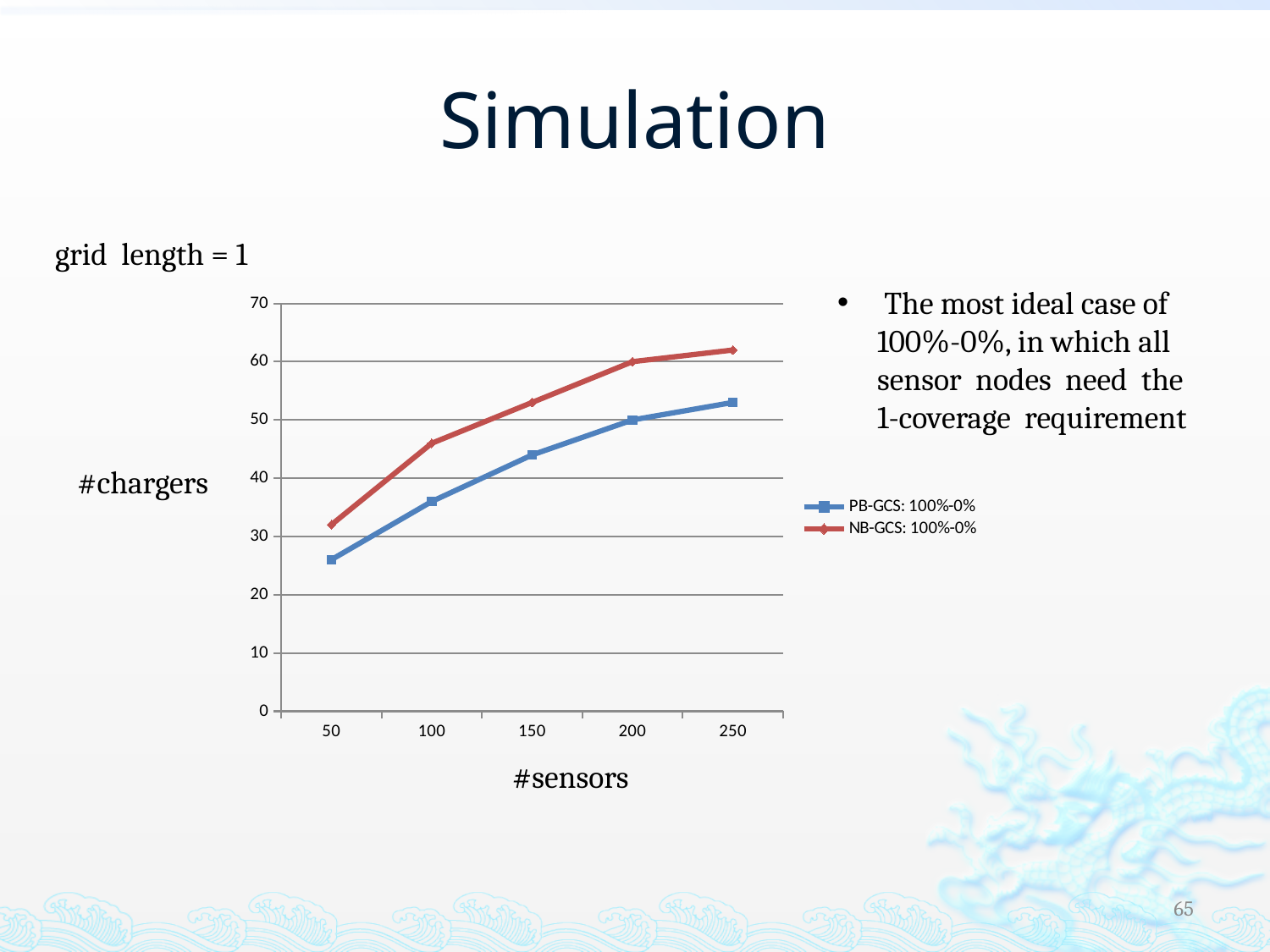
Is the value for PB-GCS: 100%-0% at 100 sensors greater or less than 40? less What is the label of the vertical axis? #chargers Is the value for NB-GCS: 100%-0% at 100 sensors greater or less than 40? greater Is the value for PB-GCS: 100%-0% at 50 sensors greater or less than 30? less What kind of chart is shown on the slide? line chart What is the value of PB-GCS: 100%-0% at 200 sensors? 50 How many #sensors values are plotted along the x axis? 5 Which series has the higher value at 150 sensors? NB-GCS: 100%-0% Do the values of PB-GCS: 100%-0% rise or fall as the number of sensors increases? rise How many series does the legend list? 2 At which number of sensors does NB-GCS: 100%-0% reach its highest value? 250 What is the value of NB-GCS: 100%-0% at 200 sensors? 60